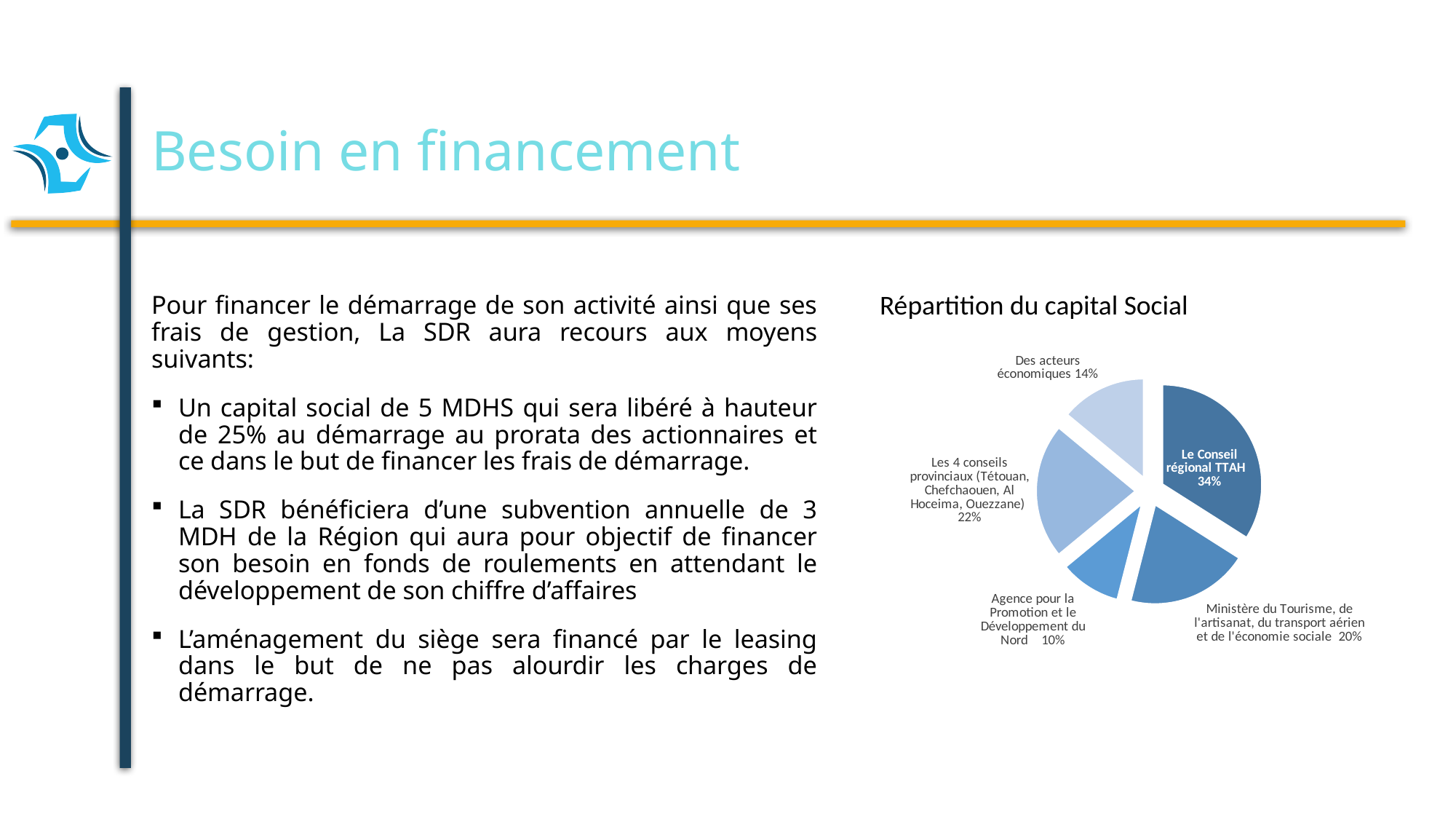
What kind of chart is shown on the slide? Pie chart What share of the capital is held by the Agence pour la Promotion et le Développement du Nord? 10% What share of the capital is held by Le Conseil régional TTAH? 34% Which holds a larger share: Des acteurs économiques or the Ministère du Tourisme? Ministère du Tourisme Which shareholder holds the largest share of the capital? Le Conseil régional TTAH What is the title of the chart? Répartition du capital Social What share of the capital is held by Les 4 conseils provinciaux (Tétouan, Chefchaouen, Al Hoceima, Ouezzane)? 22% What is the difference in share between Le Conseil régional TTAH and Les 4 conseils provinciaux? 12% What share of the capital is held by Des acteurs économiques? 14% How many slices does the pie chart have? 5 Which shareholder holds the smallest share of the capital? Agence pour la Promotion et le Développement du Nord What share of the capital is held by the Ministère du Tourisme, de l'artisanat, du transport aérien et de l'économie sociale? 20%